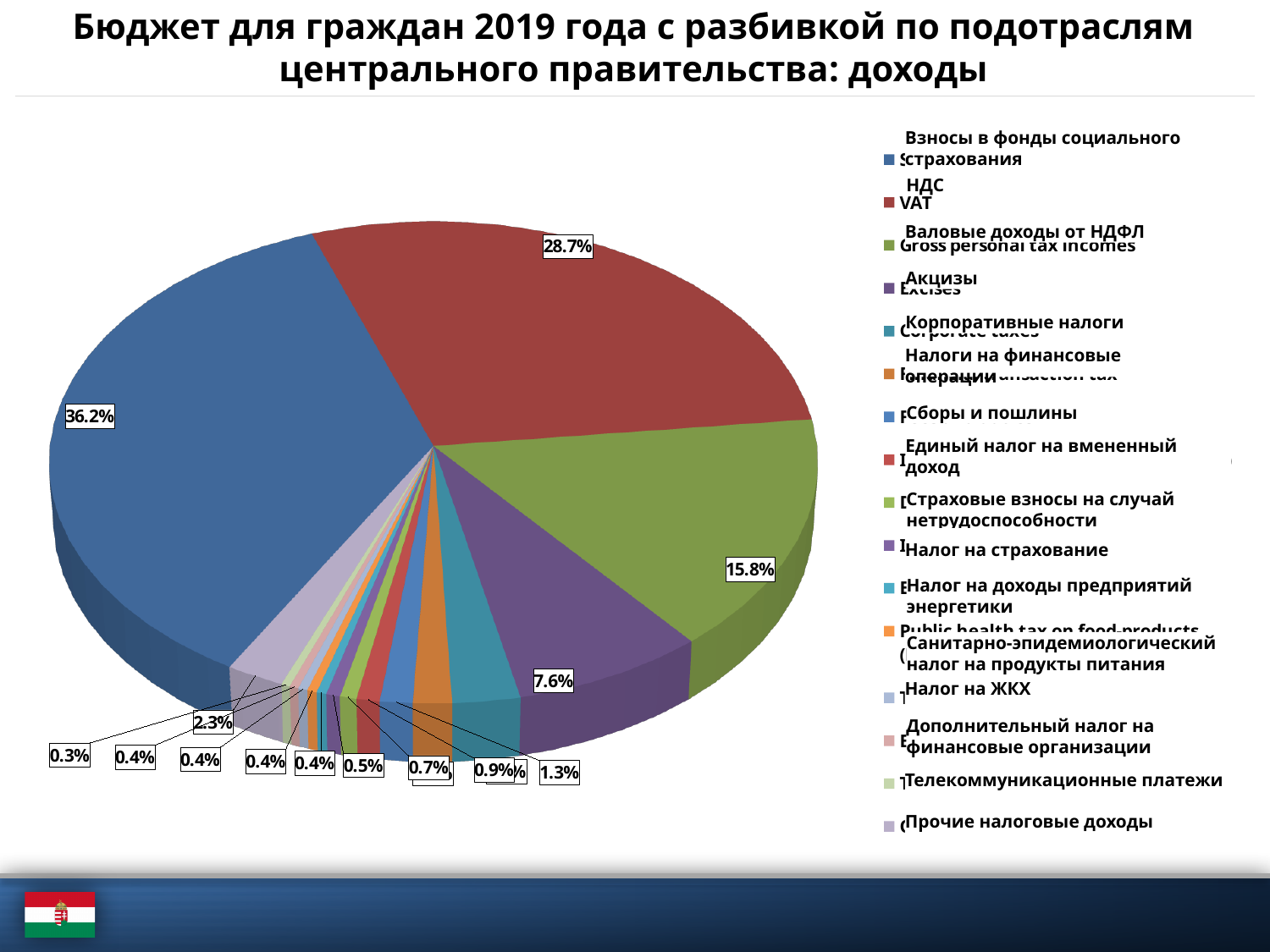
What is the title of the slide? Бюджет для граждан 2019 года с разбивкой по подотраслям центрального правительства: доходы What is the smallest percentage label printed on the chart? 0.3% What type of chart is shown on the slide? pie chart Which is larger: НДС or Валовые доходы от НДФЛ? НДС What is the combined share of Взносы в фонды социального страхования and НДС? 64.9% What share of revenues comes from Взносы в фонды социального страхования? 36.2% What share is shown for Валовые доходы от НДФЛ? 15.8% Which category has the largest slice of the pie? Взносы в фонды социального страхования What percentage is labelled for Акцизы? 7.6% What percentage of the pie is НДС? 28.7% How many categories are listed in the legend? 16 By how many percentage points does Взносы в фонды социального страхования exceed НДС? 7.5 percentage points